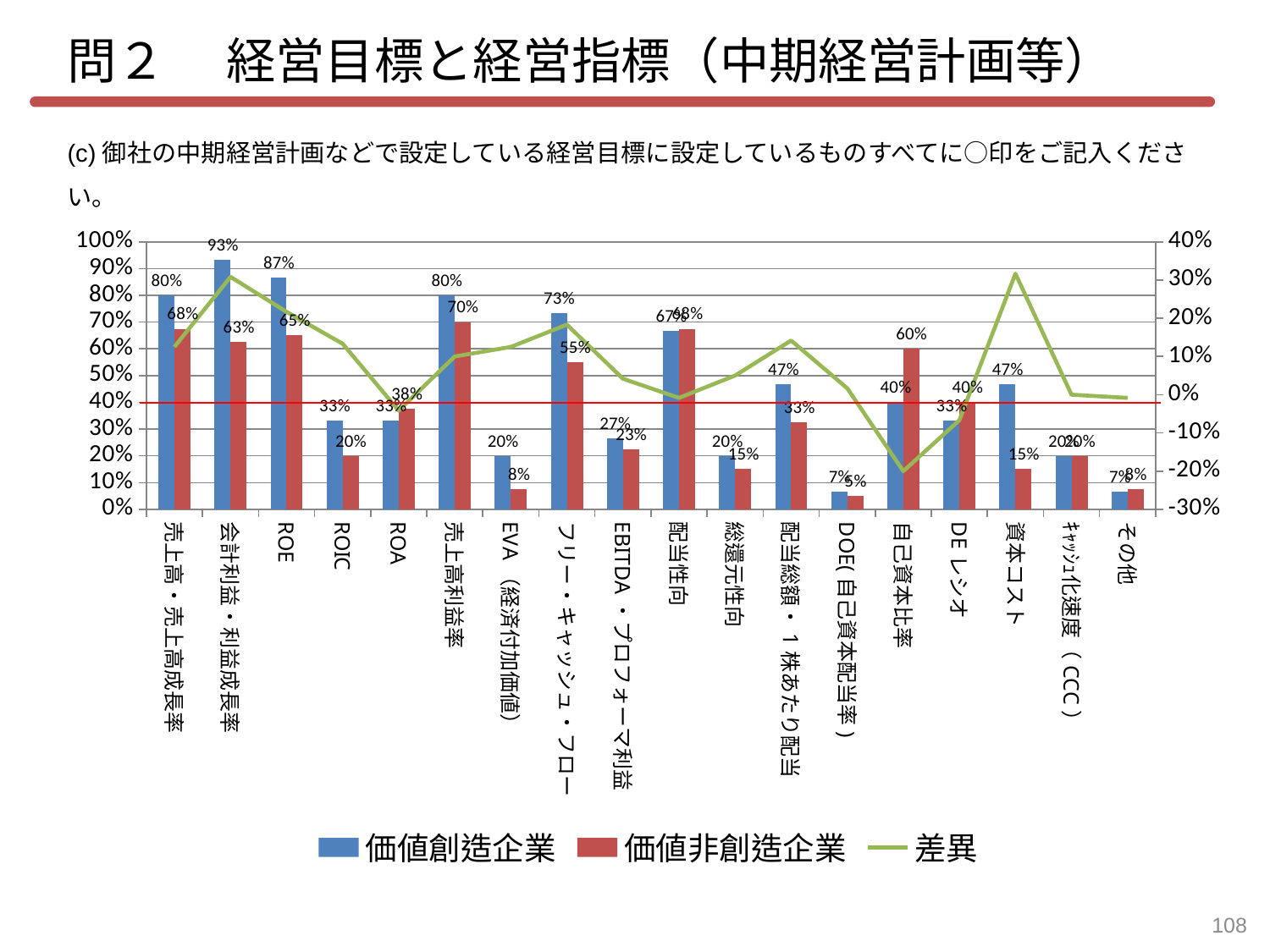
How many categories are shown on the x axis? 18 What is the difference between 価値創造企業 and 価値非創造企業 for ROE? 22% What kind of chart is this? Bar chart with a line series For フリー・キャッシュ・フロー, which is larger: 価値創造企業 or 価値非創造企業? 価値創造企業 How many series does the legend list? 3 Which category has the highest value for 価値創造企業? 会計利益・利益成長率 What is the value for 価値非創造企業 for 自己資本比率? 60% Which category has the lowest value for 価値非創造企業? DOE(自己資本配当率) What is the value for 価値非創造企業 for EVA（経済付加価値）? 8% For 自己資本比率, which is larger: 価値創造企業 or 価値非創造企業? 価値非創造企業 What is the value for 価値創造企業 for 会計利益・利益成長率? 93% What is the value for 価値創造企業 for 資本コスト? 47%